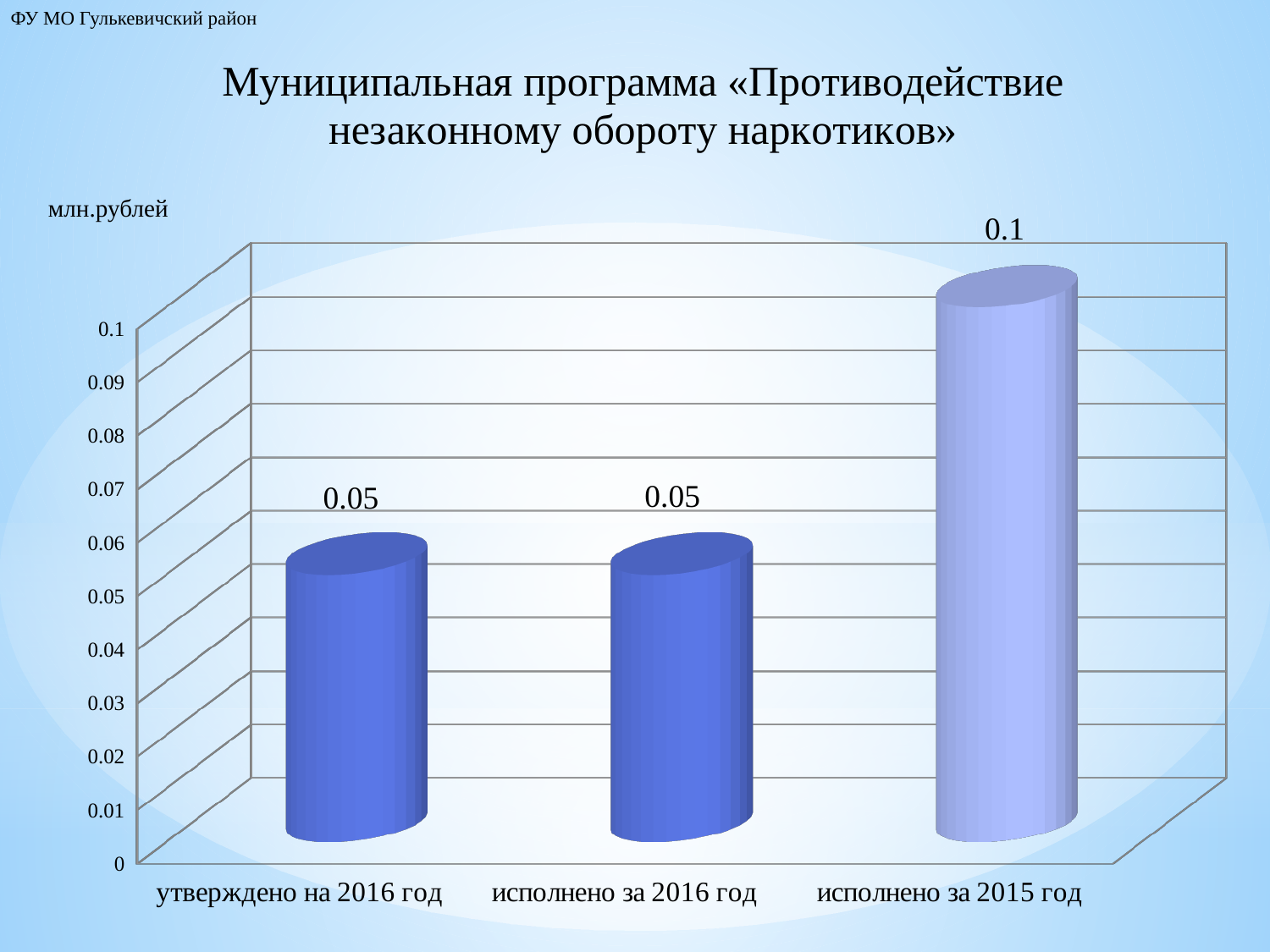
How many categories are shown on the chart? 3 What is the difference between the values for «исполнено за 2015 год» and «исполнено за 2016 год»? 0.05 Is the value for «утверждено на 2016 год» greater or less than 0.07? less What is the value for «исполнено за 2016 год»? 0.05 Is the value for «исполнено за 2015 год» greater or less than 0.08? greater What is the value for «исполнено за 2015 год»? 0.1 What is the value for «утверждено на 2016 год»? 0.05 What is the title of the slide? Муниципальная программа «Противодействие незаконному обороту наркотиков» Which is larger: the value for «исполнено за 2015 год» or the value for «утверждено на 2016 год»? исполнено за 2015 год What unit of measurement is indicated above the chart? млн.рублей What kind of chart is shown on the slide? bar chart Which category has the highest value? исполнено за 2015 год